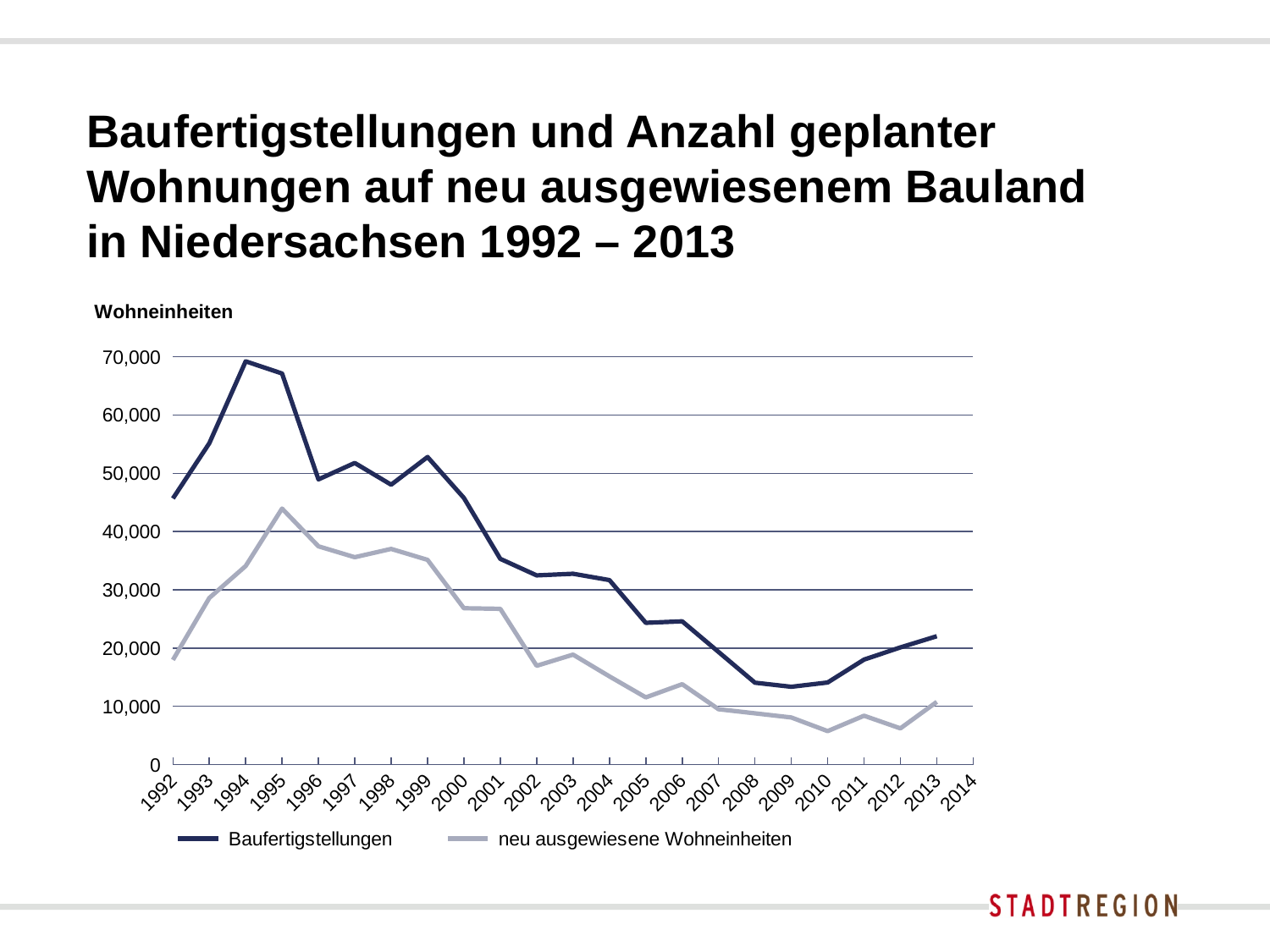
Is the value for Baufertigstellungen in 1994 greater or less than 60,000? greater Which series has the larger value in 1994, Baufertigstellungen or neu ausgewiesene Wohneinheiten? Baufertigstellungen In which year does the neu ausgewiesene Wohneinheiten series reach its highest value? 1995 What are the two series named in the legend? Baufertigstellungen and neu ausgewiesene Wohneinheiten What label is shown above the y axis? Wohneinheiten In which year does the Baufertigstellungen series reach its highest value? 1994 How many series does the legend list? 2 Is the value for Baufertigstellungen in 2005 greater or less than 20,000? greater What kind of chart is shown on the slide? line chart How many year labels are shown on the x axis? 23 Does the Baufertigstellungen series rise or fall between 1995 and 2009? fall Is the value for neu ausgewiesene Wohneinheiten in 1992 greater or less than 20,000? less